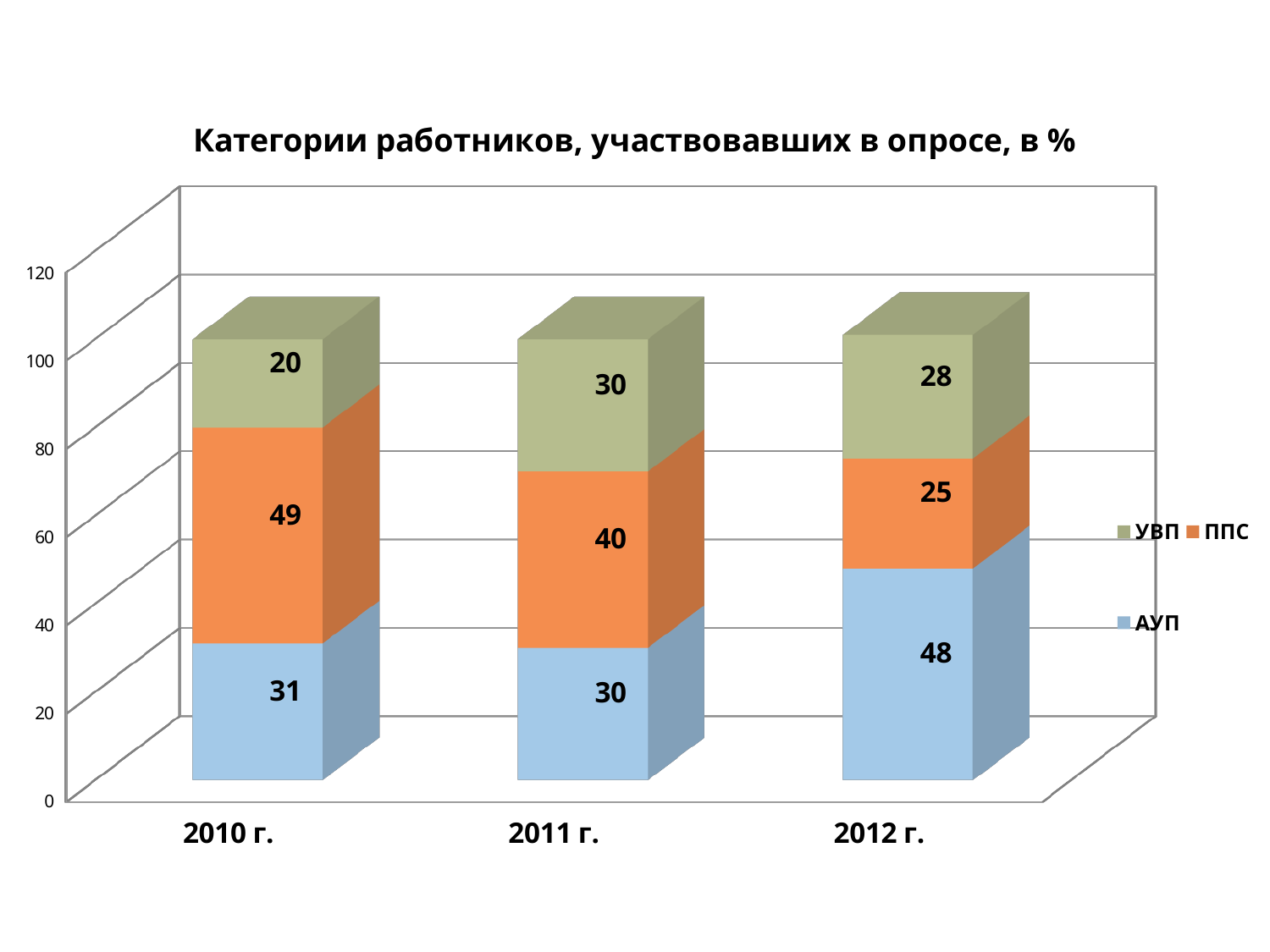
How many series does the legend list? 3 What is the total of the stacked bar for 2011 г.? 100 What is the title of the chart? Категории работников, участвовавших в опросе, в % In which year is the УВП value the lowest? 2010 г. How many categories (years) are shown on the x axis? 3 What is the value for ППС in 2010 г.? 49 What is the value for УВП in 2011 г.? 30 Which is larger: the АУП value in 2012 г. or the АУП value in 2011 г.? 2012 г. What is the difference between the ППС values for 2010 г. and 2012 г.? 24 What is the value for АУП in 2012 г.? 48 In which year is the ППС value the highest? 2010 г. What type of chart is shown on the slide? Stacked bar chart